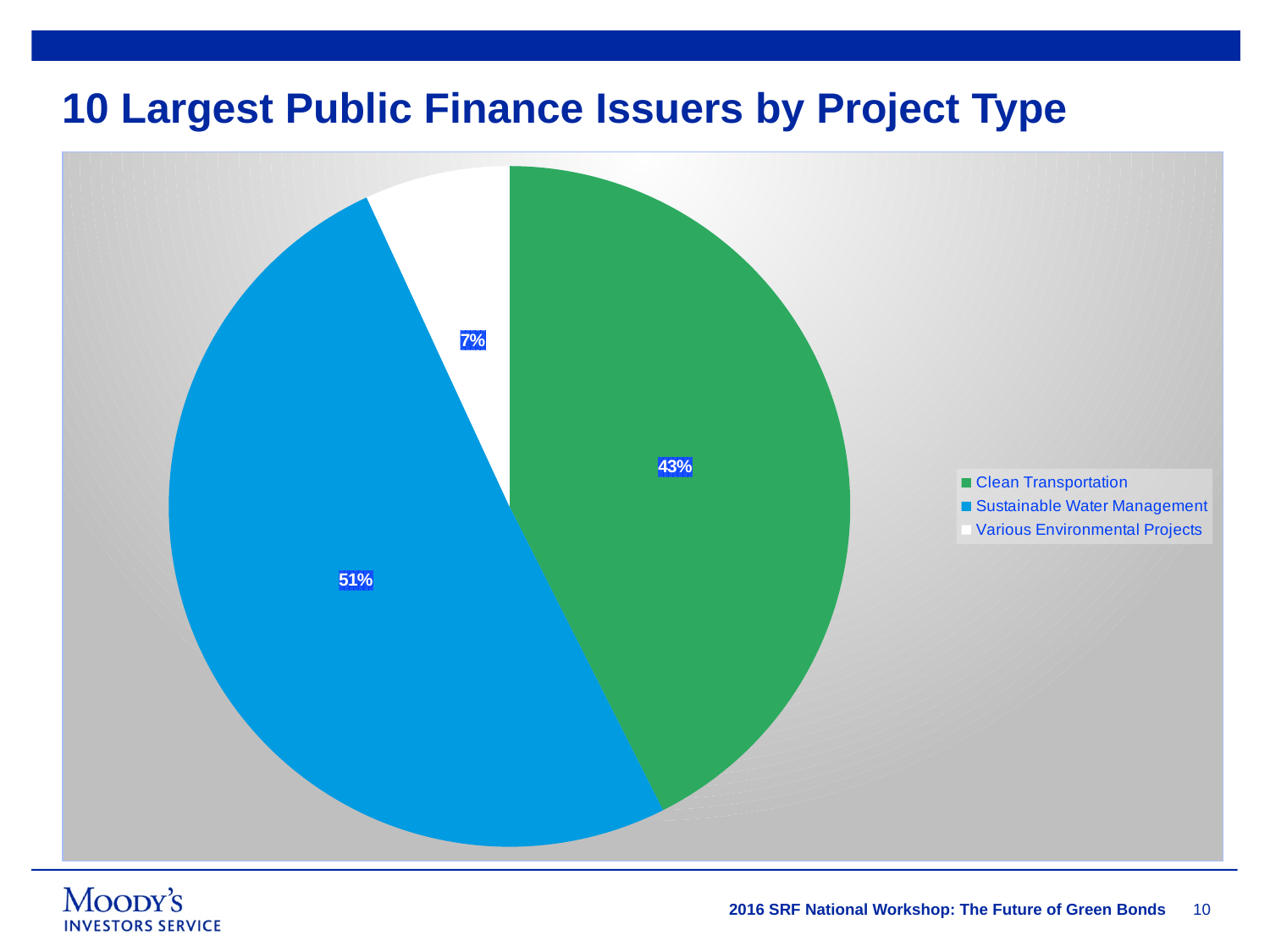
What colour is the Clean Transportation slice? green Which project type has the smallest slice of the pie? Various Environmental Projects What kind of chart is shown on the slide? pie chart What share of the pie does Various Environmental Projects have? 7% What is the title of the chart? 10 Largest Public Finance Issuers by Project Type What is the difference in percentage points between Clean Transportation and Various Environmental Projects? 36 What share of the pie does Clean Transportation have? 43% What share of the pie does Sustainable Water Management have? 51% Which is larger, the share for Clean Transportation or the share for Various Environmental Projects? Clean Transportation How many slices does the pie chart have? 3 What is the difference in percentage points between Sustainable Water Management and Clean Transportation? 8 Which project type has the largest slice of the pie? Sustainable Water Management